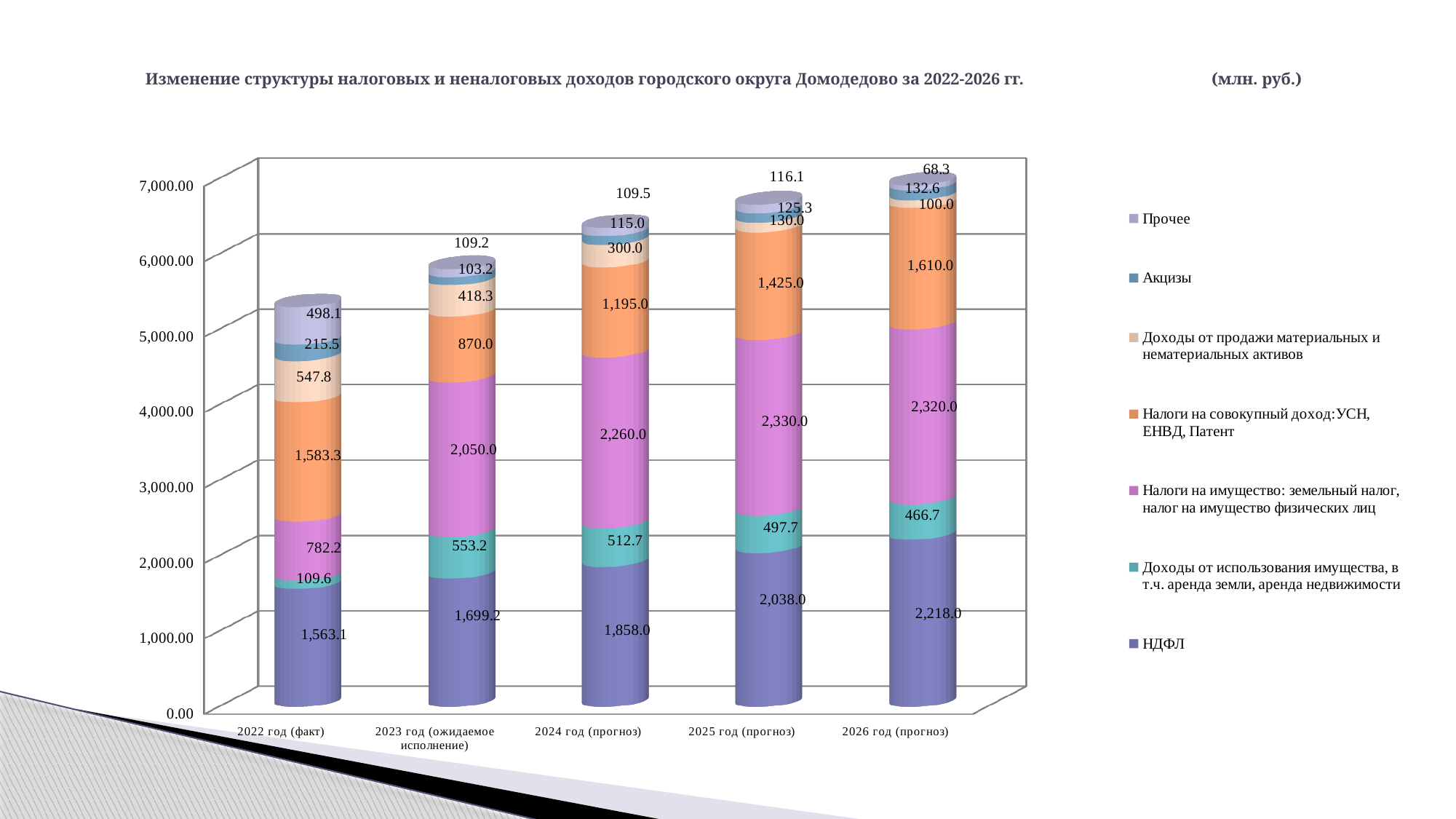
What kind of chart is shown on the slide? Stacked bar chart What is the total of the stacked bar for 2022 год (факт)? 5,299.6 What is the value of НДФЛ for 2022 год (факт)? 1,563.1 In which year is the Прочее value the lowest? 2026 год (прогноз) In which year is the НДФЛ value the highest? 2026 год (прогноз) Which is larger: Налоги на имущество for 2025 год (прогноз) or for 2026 год (прогноз)? 2025 год (прогноз) What is the value of Налоги на совокупный доход: УСН, ЕНВД, Патент for 2026 год (прогноз)? 1,610.0 How many year categories are shown on the x axis? 5 How many series does the legend list? 7 Does the НДФЛ value rise or fall from 2022 to 2026? Rises What is the value of Доходы от продажи материальных и нематериальных активов for 2023 год (ожидаемое исполнение)? 418.3 What is the difference between the НДФЛ value for 2026 год (прогноз) and for 2022 год (факт)? 654.9